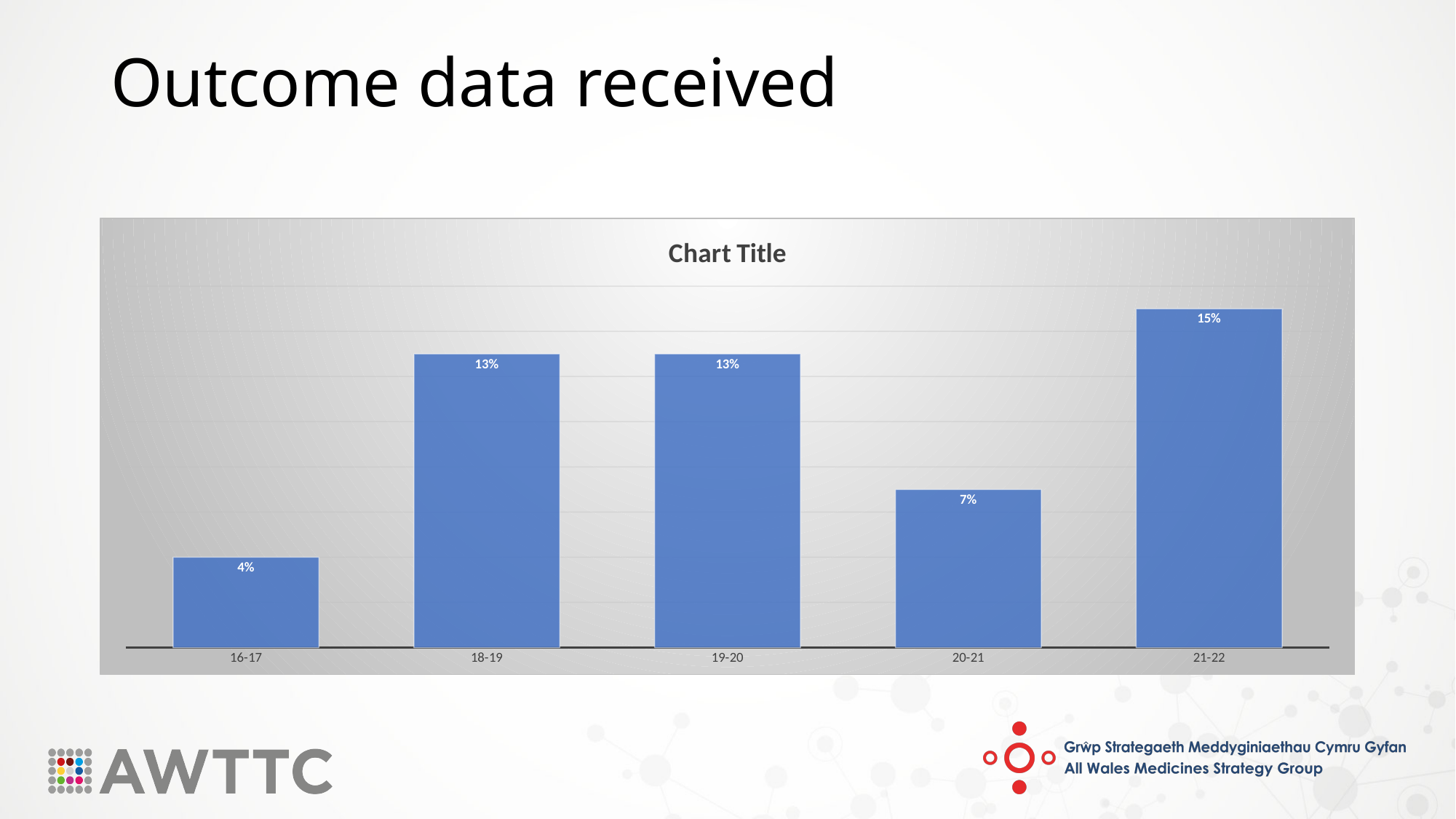
What is the value for 21-22? 15% Which is larger, the value for 20-21 or the value for 21-22? 21-22 Which category has the highest value? 21-22 What is the value for 20-21? 7% What is the difference between the values for 19-20 and 20-21? 6% What is the title shown above the chart? Chart Title What is the value for 16-17? 4% What is the difference between the values for 21-22 and 16-17? 11% What kind of chart is shown on the slide? Bar chart What is the value for 18-19? 13% Which category has the lowest value? 16-17 How many categories are shown on the x axis? 5